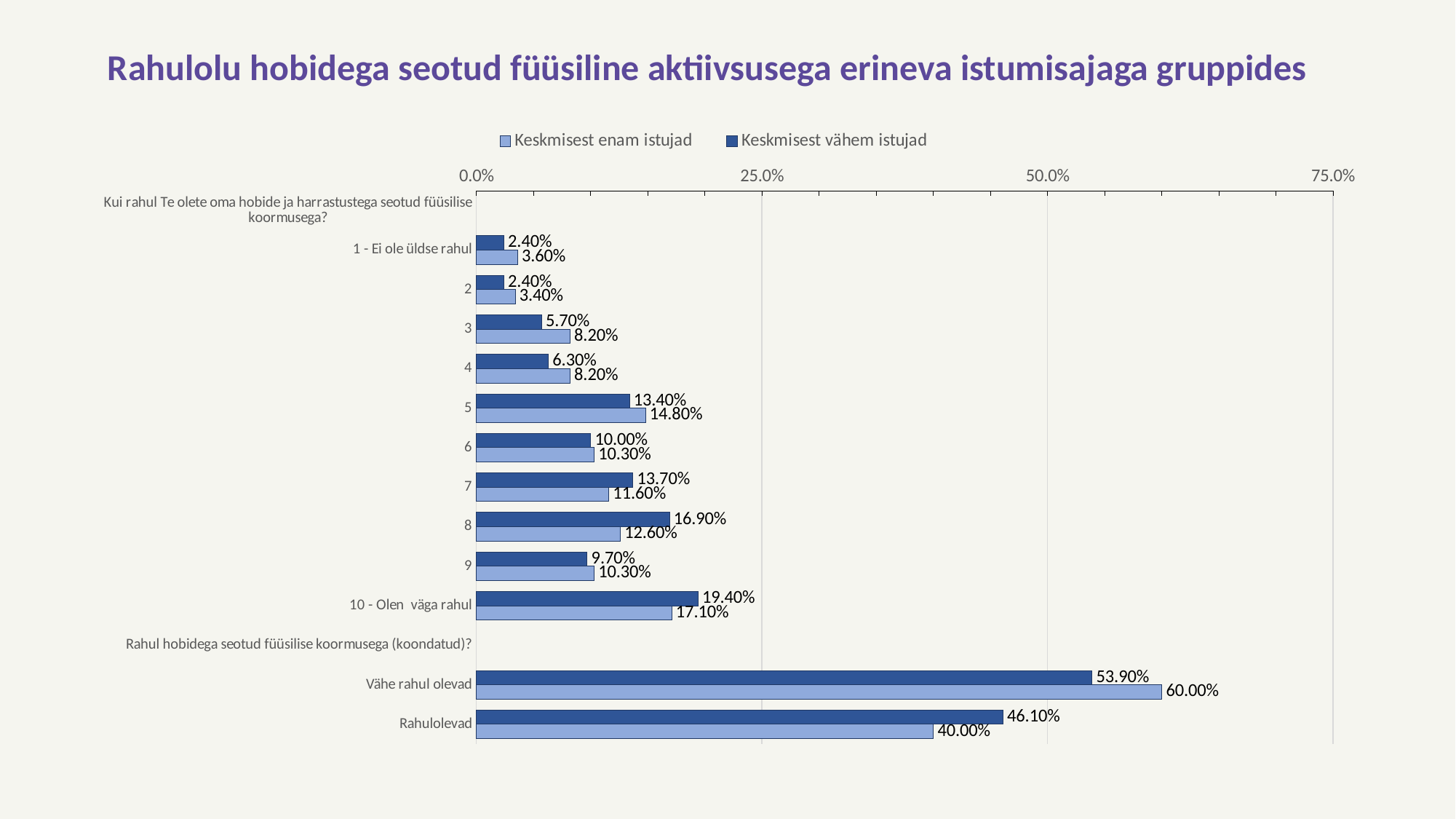
Which legend entry is shown in the lighter blue colour? Keskmisest enam istujad How many series does the legend list? 2 Among the categories 1 to 10, which has the highest value for "Keskmisest vähem istujad"? 10 - Olen väga rahul Is the value for "Keskmisest vähem istujad" in the category "Rahulolevad" greater or less than 50.0%? less What is the value for "Keskmisest vähem istujad" in the category "Vähe rahul olevad"? 53.90% In category 8, which series has the larger value, "Keskmisest enam istujad" or "Keskmisest vähem istujad"? Keskmisest vähem istujad What is the difference between "Keskmisest enam istujad" and "Keskmisest vähem istujad" in the category "Vähe rahul olevad"? 6.10% Among the categories 1 to 10, which has the lowest value for "Keskmisest enam istujad"? 2 What is the value for "Keskmisest enam istujad" in the category "10 - Olen väga rahul"? 17.10% What is the value for "Keskmisest enam istujad" in the category "Rahulolevad"? 40.00% What kind of chart is shown on the slide? Bar chart What is the value for "Keskmisest vähem istujad" in category 8? 16.90%